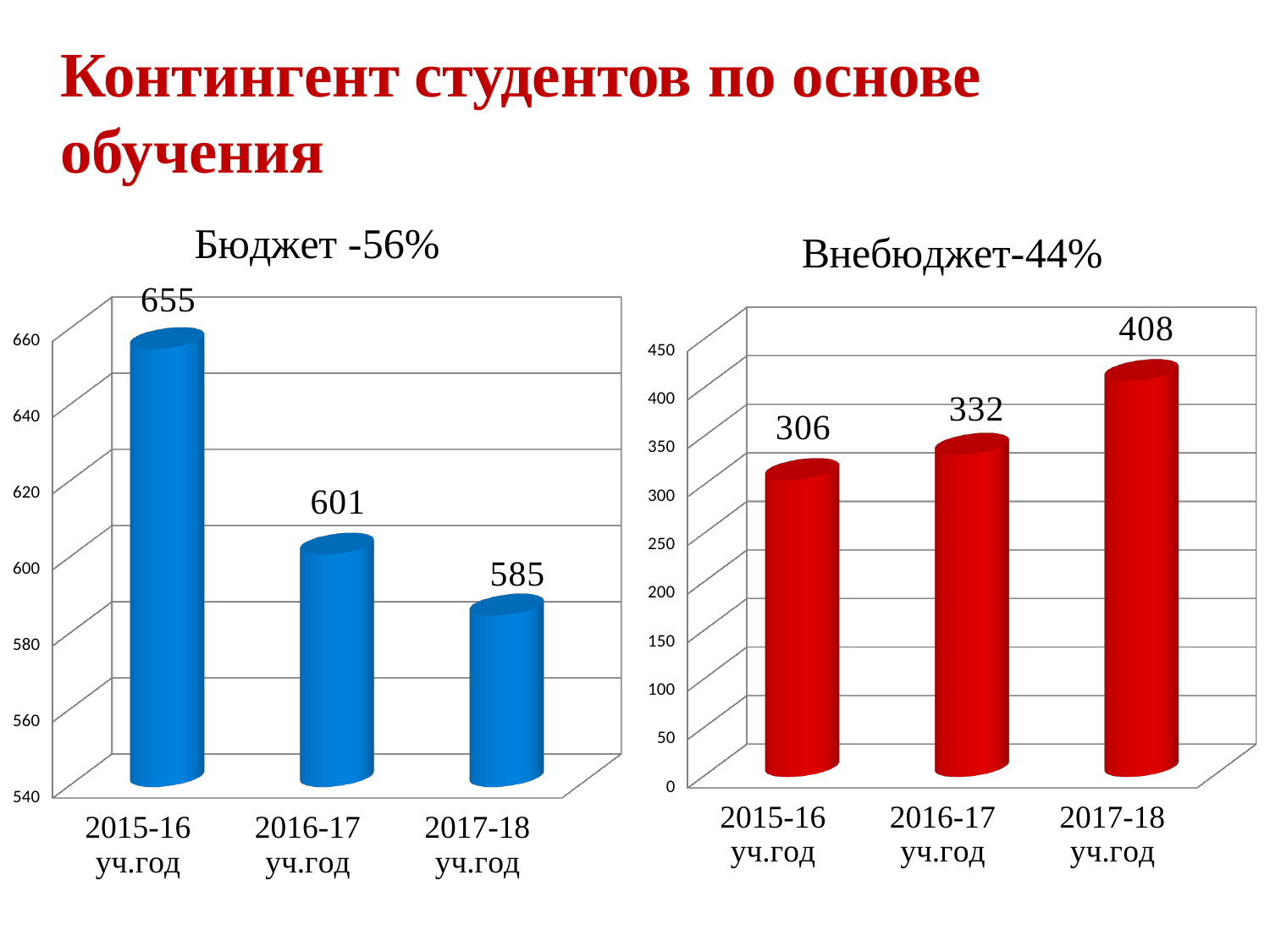
In the 'Внебюджет-44%' chart, which is larger: the value for 2015-16 уч.год or 2016-17 уч.год? 2016-17 уч.год What colour are the bars in the 'Внебюджет-44%' chart? red In the 'Внебюджет-44%' chart, what is the difference between the values for 2017-18 уч.год and 2016-17 уч.год? 76 In the 'Внебюджет-44%' chart, which year has the highest value? 2017-18 уч.год In the 'Бюджет -56%' chart, what is the difference between the values for 2015-16 уч.год and 2017-18 уч.год? 70 What kind of chart is the 'Бюджет -56%' chart? bar chart How many categories are shown in the 'Внебюджет-44%' chart? 3 In the 'Бюджет -56%' chart, what is the value for 2015-16 уч.год? 655 In the 'Внебюджет-44%' chart, what is the value for 2017-18 уч.год? 408 In the 'Бюджет -56%' chart, which year has the lowest value? 2017-18 уч.год In the 'Бюджет -56%' chart, is the value for 2016-17 уч.год greater or less than 620? less In the 'Бюджет -56%' chart, do the values rise or fall from 2015-16 to 2017-18? fall